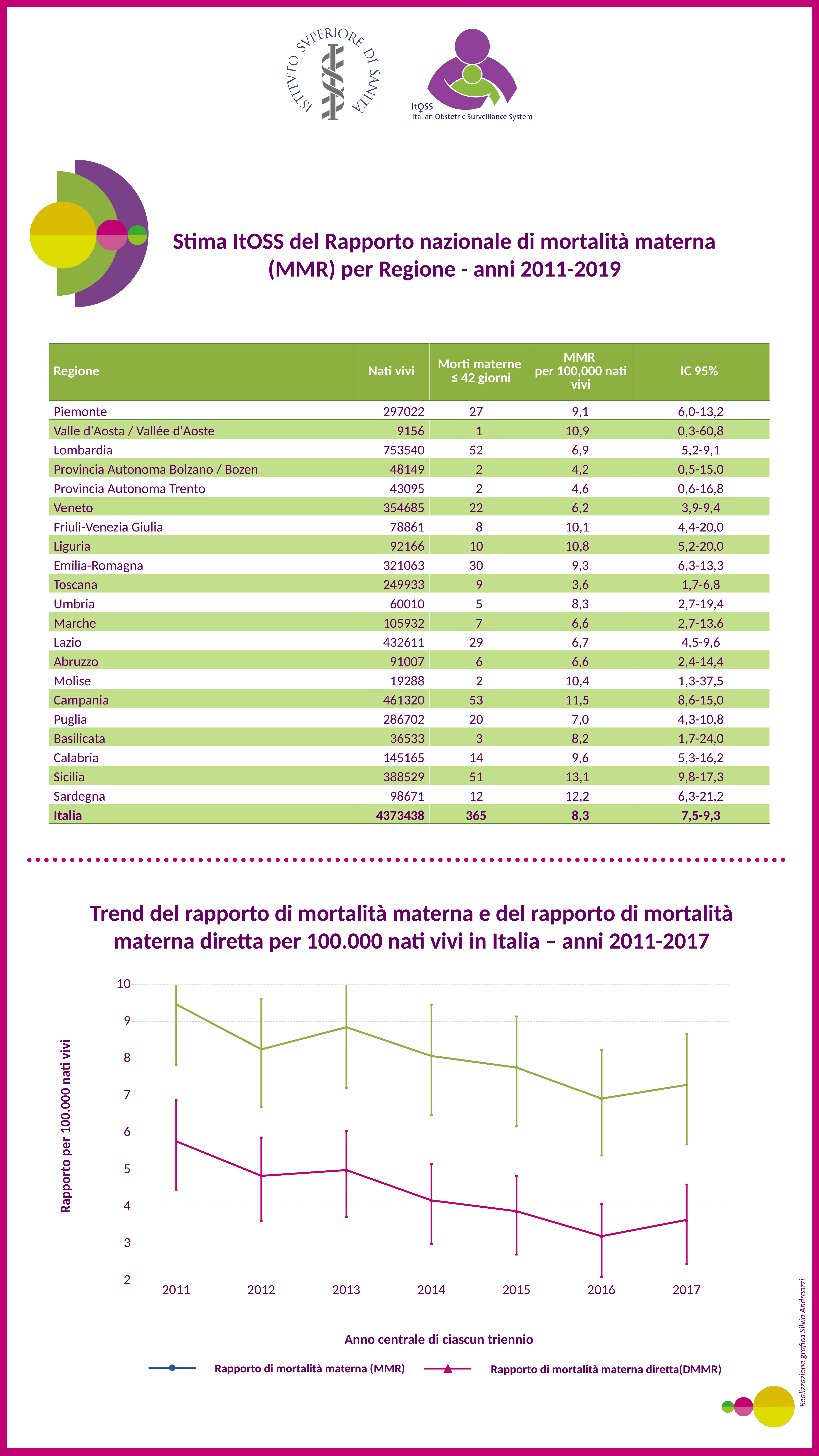
What kind of chart is shown at the bottom of the slide? line chart In the trend chart, which is larger: the MMR value for 2011 or the MMR value for 2017? 2011 What is the x-axis title of the trend chart? Anno centrale di ciascun triennio In the trend chart, is the MMR value for 2016 greater or less than 8? less In the trend chart, does the MMR series generally rise or fall from 2011 to 2017? fall In the trend chart, is the MMR value for 2011 greater or less than 9? greater How many years are plotted along the x axis of the trend chart? 7 In the trend chart, in which year is the DMMR series lowest? 2016 In the trend chart, is the DMMR value for 2016 greater or less than 4? less How many series does the legend of the trend chart list? 2 In the trend chart, in which year is the MMR series highest? 2011 In the trend chart, in which year is the MMR series lowest? 2016